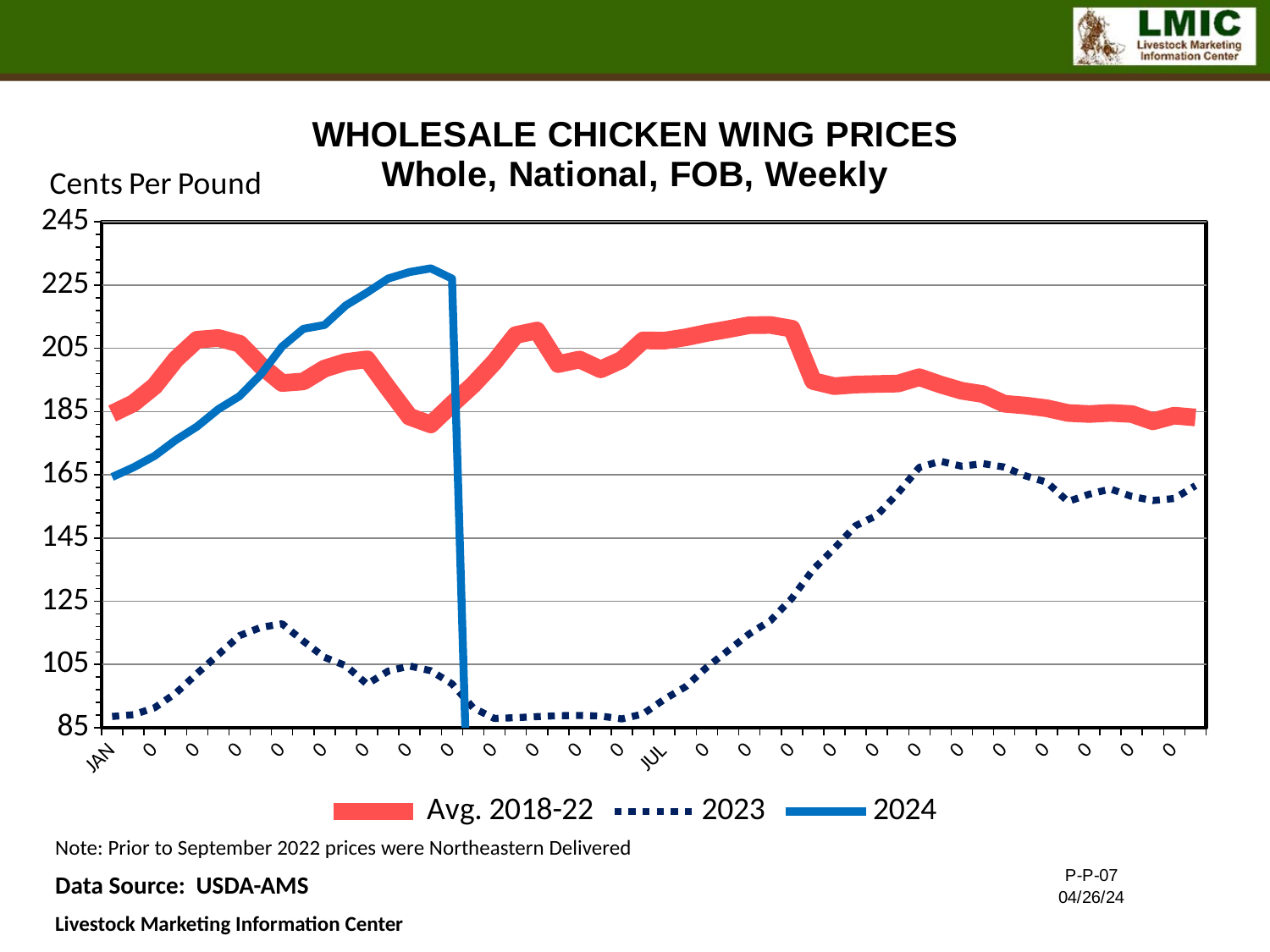
How many series does the legend list? 3 Does the 2024 line generally rise or fall from JAN to its last plotted point? rise At JUL, is the value of the 2023 line greater or less than 105? less What is the main title of the chart? WHOLESALE CHICKEN WING PRICES At JAN, is the value of the Avg. 2018-22 line greater or less than 165? greater At JAN, which series has the higher value, 2024 or 2023? 2024 What kind of chart is shown on the slide? line chart What are the three series named in the legend? Avg. 2018-22, 2023, 2024 At JAN, is the value of the 2023 line greater or less than 105? less At JUL, which series has the higher value, Avg. 2018-22 or 2023? Avg. 2018-22